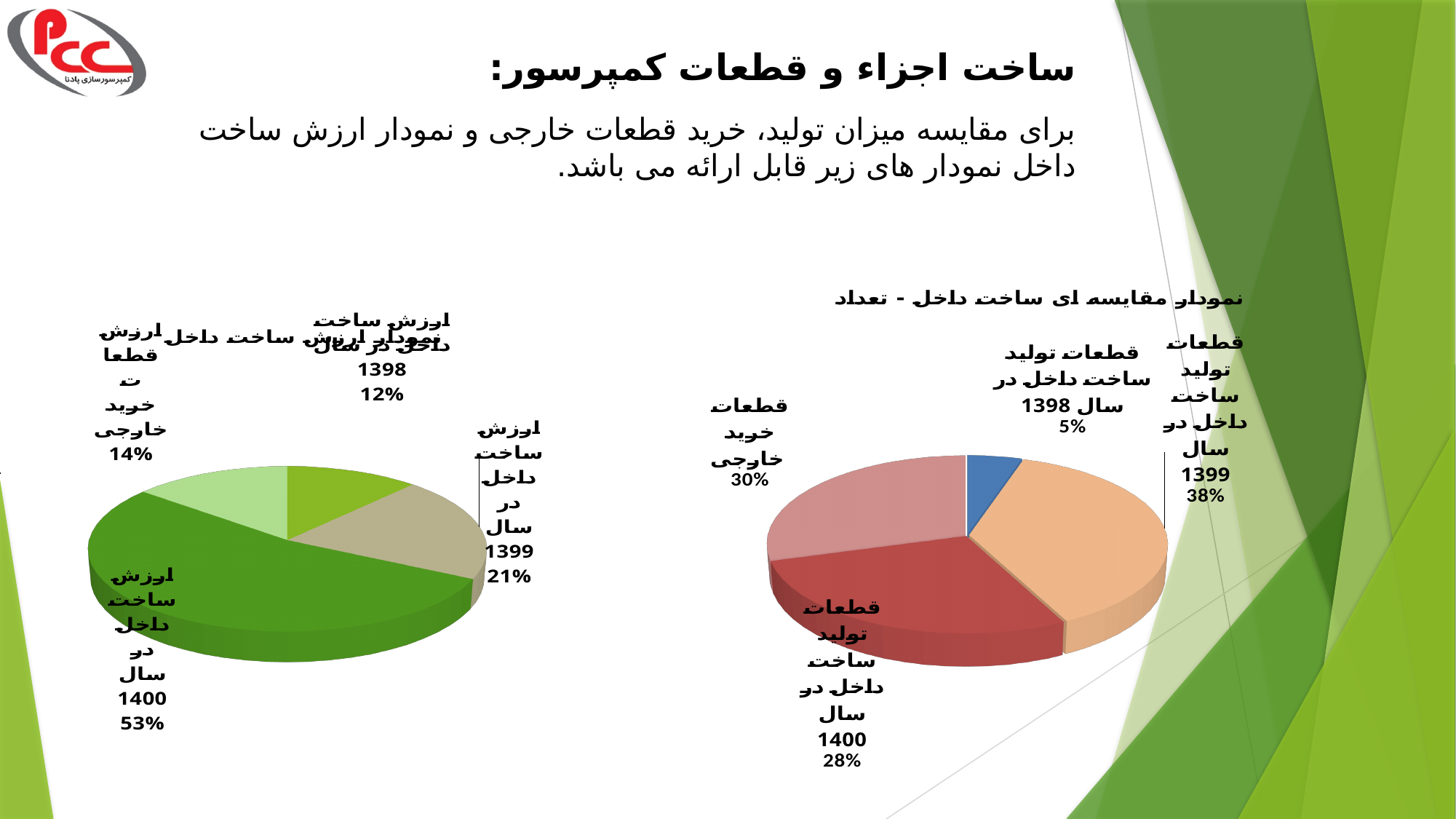
In the right-hand pie chart, how many slices are there? 4 In the right-hand pie chart (نمودار مقایسه ای ساخت داخل - تعداد), what share is shown for قطعات تولید ساخت داخل در سال 1399? 38% In the right-hand pie chart, which slice is the smallest? قطعات تولید ساخت داخل در سال 1398 In the left-hand pie chart, which slice is the largest? ارزش ساخت داخل در سال 1400 In the right-hand pie chart, which slice is the largest? قطعات تولید ساخت داخل در سال 1399 In the left-hand pie chart, what share is shown for ارزش قطعات خرید خارجی? 14% What type of chart is used on this slide? Pie chart In the right-hand pie chart, which is larger: the share for سال 1400 or the share for قطعات خرید خارجی? قطعات خرید خارجی In the right-hand pie chart, what share is shown for قطعات تولید ساخت داخل در سال 1398? 5% In the left-hand pie chart, what is the difference in percentage points between ارزش ساخت داخل در سال 1399 and ارزش ساخت داخل در سال 1398? 9 percentage points